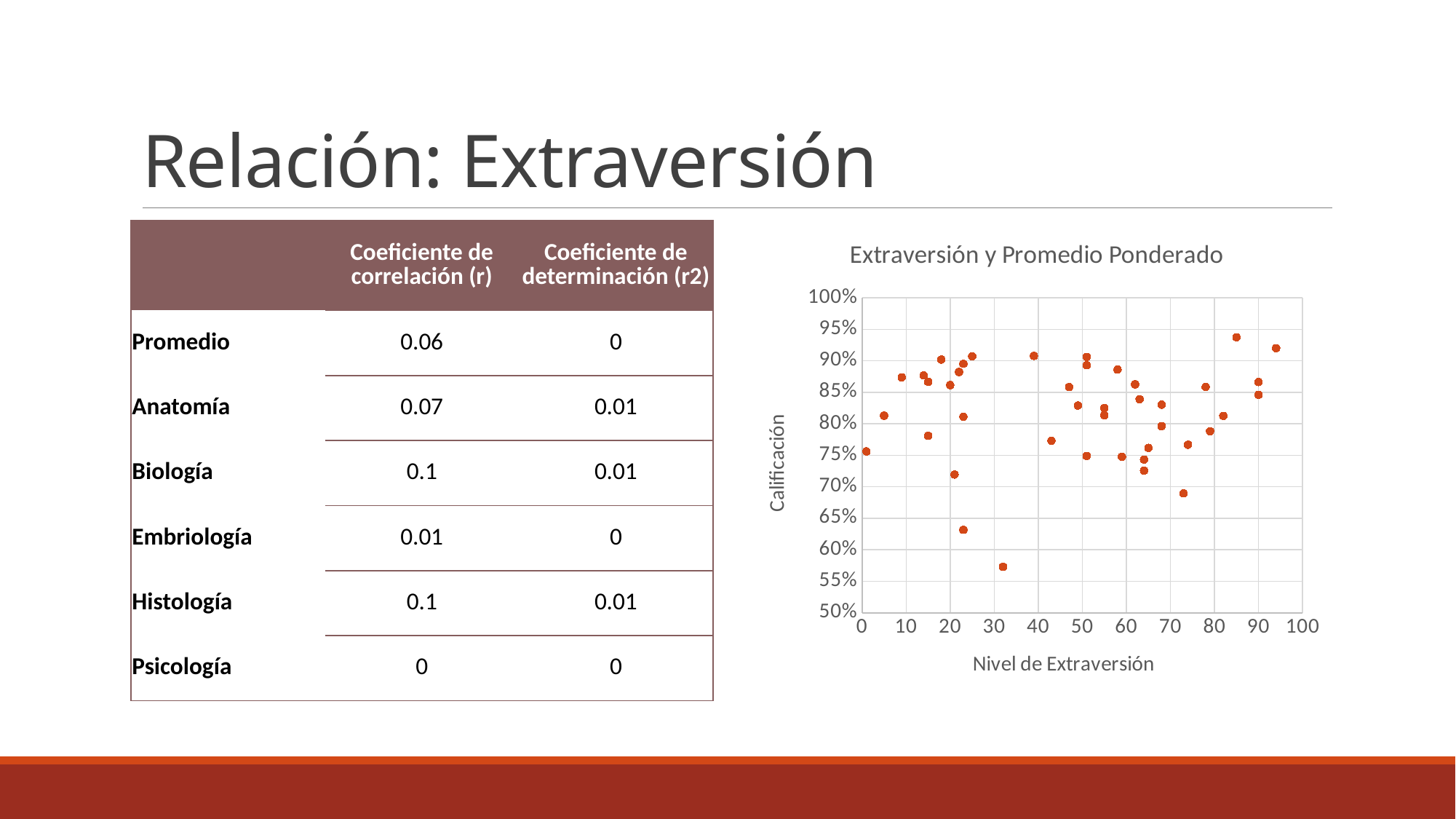
What kind of chart is shown on the slide? scatter chart What is the highest value shown on the vertical axis of the chart? 100% What is the lowest value shown on the vertical axis of the chart? 50% What is the title of the chart on the slide? Extraversión y Promedio Ponderado In the chart, is the Nivel de Extraversión of the point with the lowest Calificación greater or less than 50? less In the chart, is the lowest plotted Calificación value greater or less than 60%? less What is the highest value shown on the horizontal axis of the chart? 100 What is the label of the horizontal axis of the chart? Nivel de Extraversión In the chart, is the highest plotted Calificación value greater or less than 90%? greater